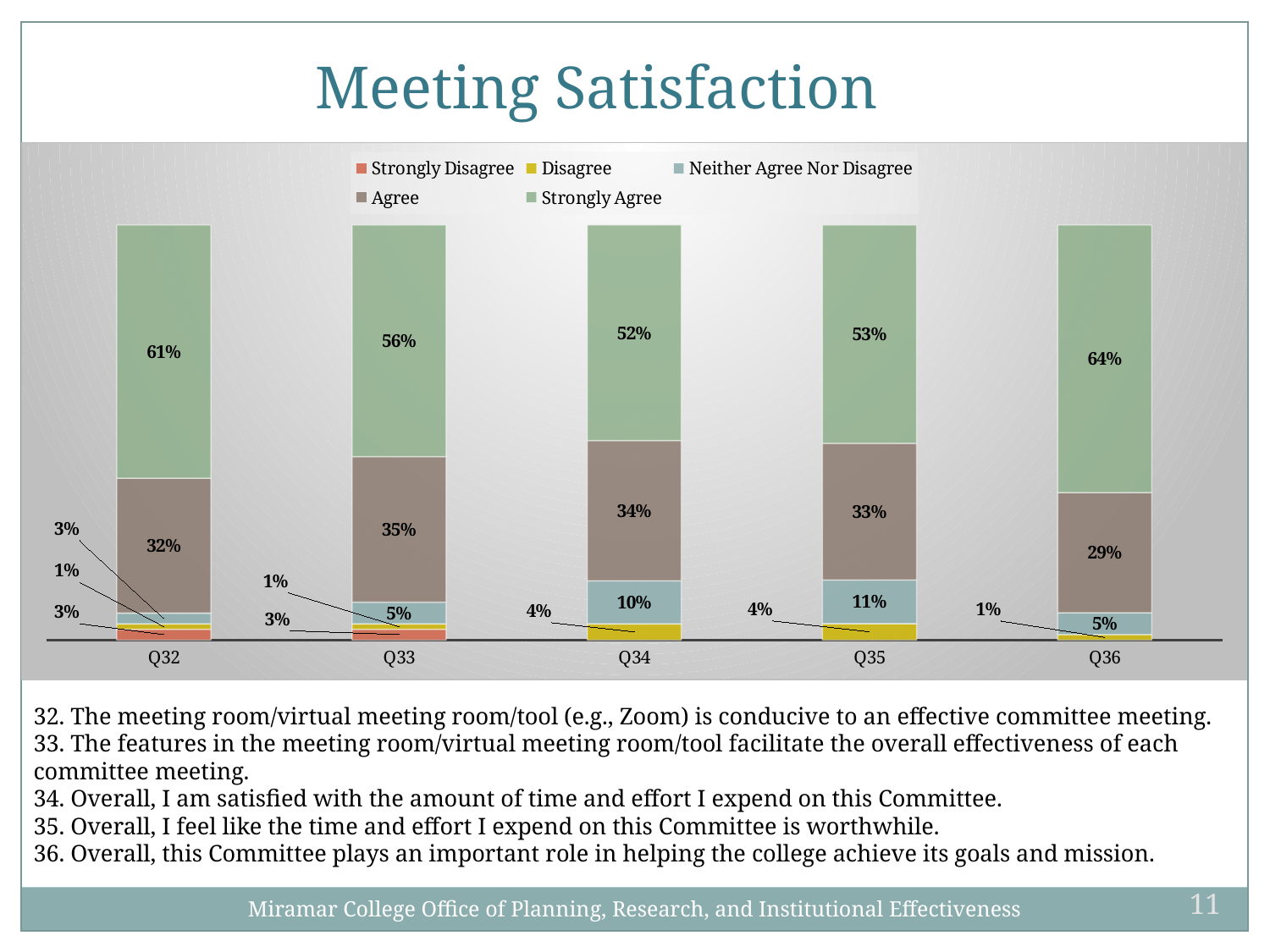
What is the title of the chart? Meeting Satisfaction What is the difference between the Strongly Agree values for Q36 and Q34? 12 percentage points What is the Agree value for Q33? 35% What kind of chart is shown on the slide? Stacked bar chart How many series does the legend list? 5 Which question has the highest Strongly Agree percentage? Q36 What is the total of the stacked bar for Q34? 100% Which question has the lowest Strongly Agree percentage? Q34 Which has a larger Agree value, Q33 or Q36? Q33 What is the Strongly Agree value for Q36? 64% What is the Neither Agree Nor Disagree value for Q35? 11% How many questions (categories) are shown on the x axis? 5